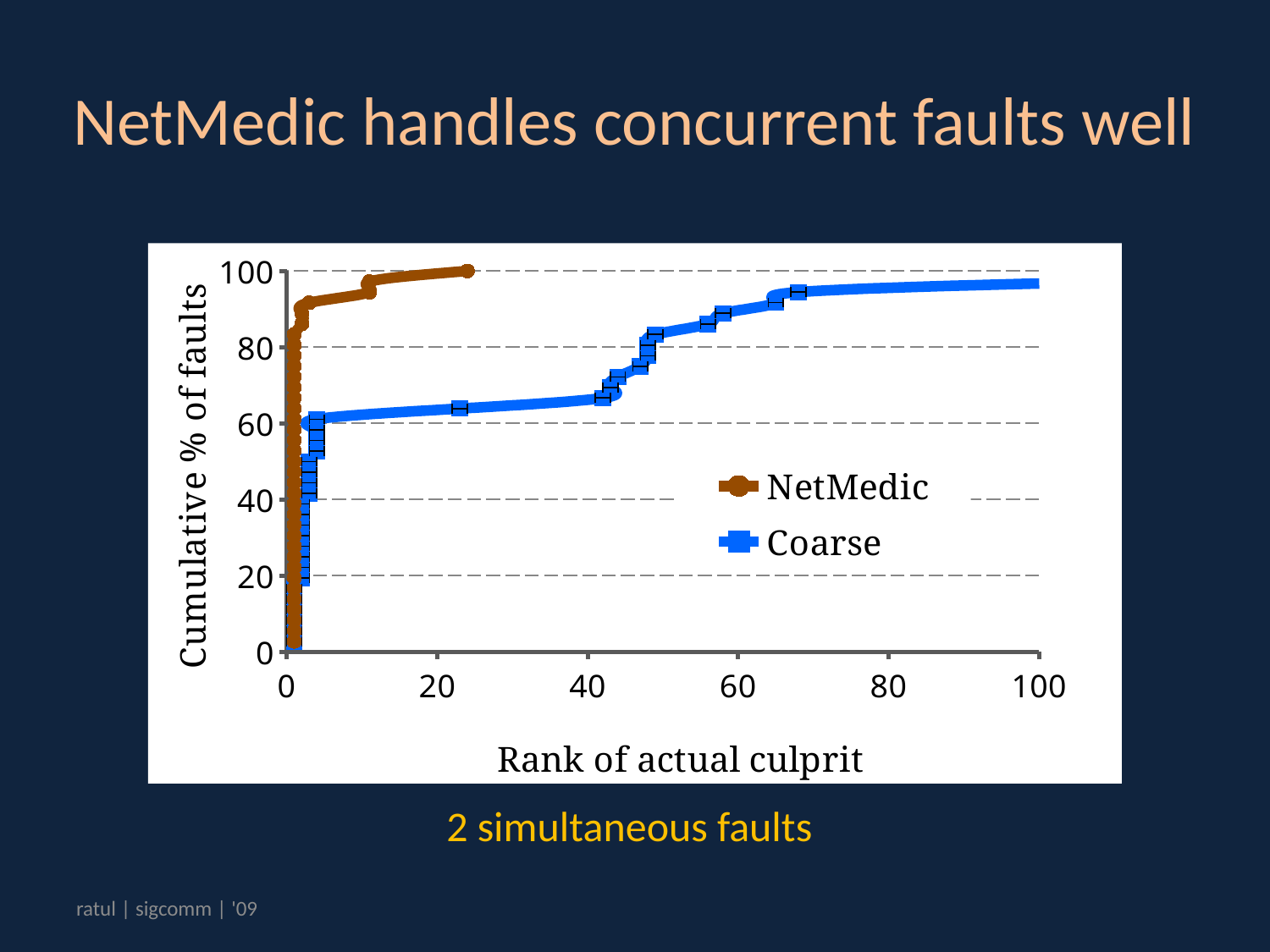
What are the two series named in the legend? NetMedic and Coarse Is the cumulative % of faults for Coarse at rank 40 greater or less than 80? less How many series does the legend list? 2 Is the cumulative % of faults for Coarse at rank 60 greater or less than 80? greater What is the label of the x axis? Rank of actual culprit What kind of chart is shown on the slide? line chart Is the cumulative % of faults for NetMedic at rank 20 greater or less than 80? greater Do the cumulative % of faults values rise or fall as the rank of actual culprit increases? rise Which series reaches 100% cumulative faults at a lower rank? NetMedic At rank 20, which series has the higher cumulative % of faults, NetMedic or Coarse? NetMedic